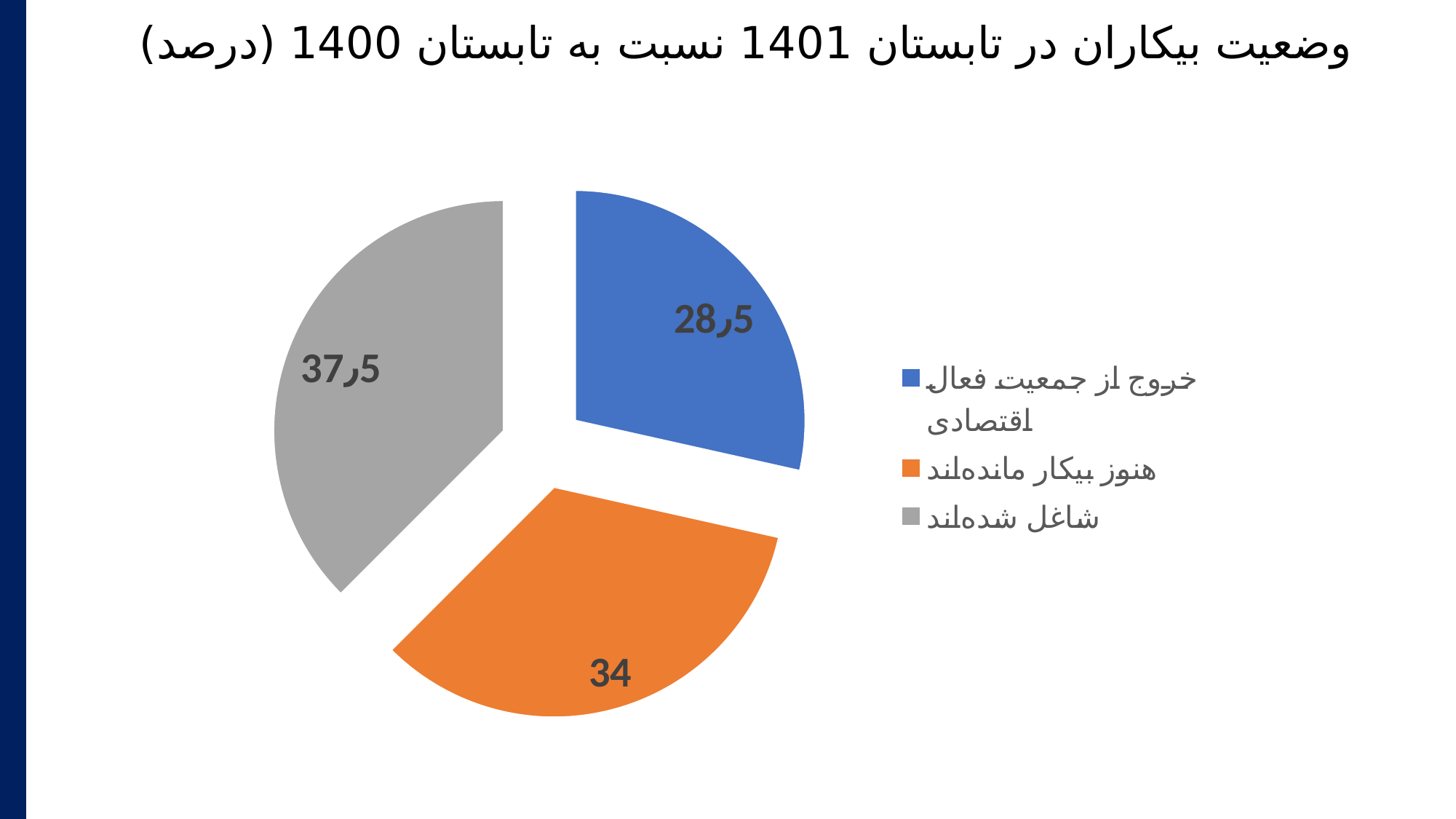
What is the title of the chart? وضعیت بیکاران در تابستان 1401 نسبت به تابستان 1400 (درصد) Which category has the largest slice of the pie? شاغل شده‌اند What is the value for the slice labelled "خروج از جمعیت فعال اقتصادی"? 28,5 What is the difference between the values for "شاغل شده‌اند" and "خروج از جمعیت فعال اقتصادی"? 9 What is the difference between the values for "شاغل شده‌اند" and "هنوز بیکار مانده‌اند"? 3,5 What colour is the slice for "هنوز بیکار مانده‌اند"? orange Which is larger, the value for "هنوز بیکار مانده‌اند" or the value for "خروج از جمعیت فعال اقتصادی"? هنوز بیکار مانده‌اند How many slices does the pie chart have? 3 What type of chart is shown on the slide? pie chart Which category has the smallest slice of the pie? خروج از جمعیت فعال اقتصادی What is the value for the slice labelled "شاغل شده‌اند"? 37,5 What is the value for the slice labelled "هنوز بیکار مانده‌اند"? 34